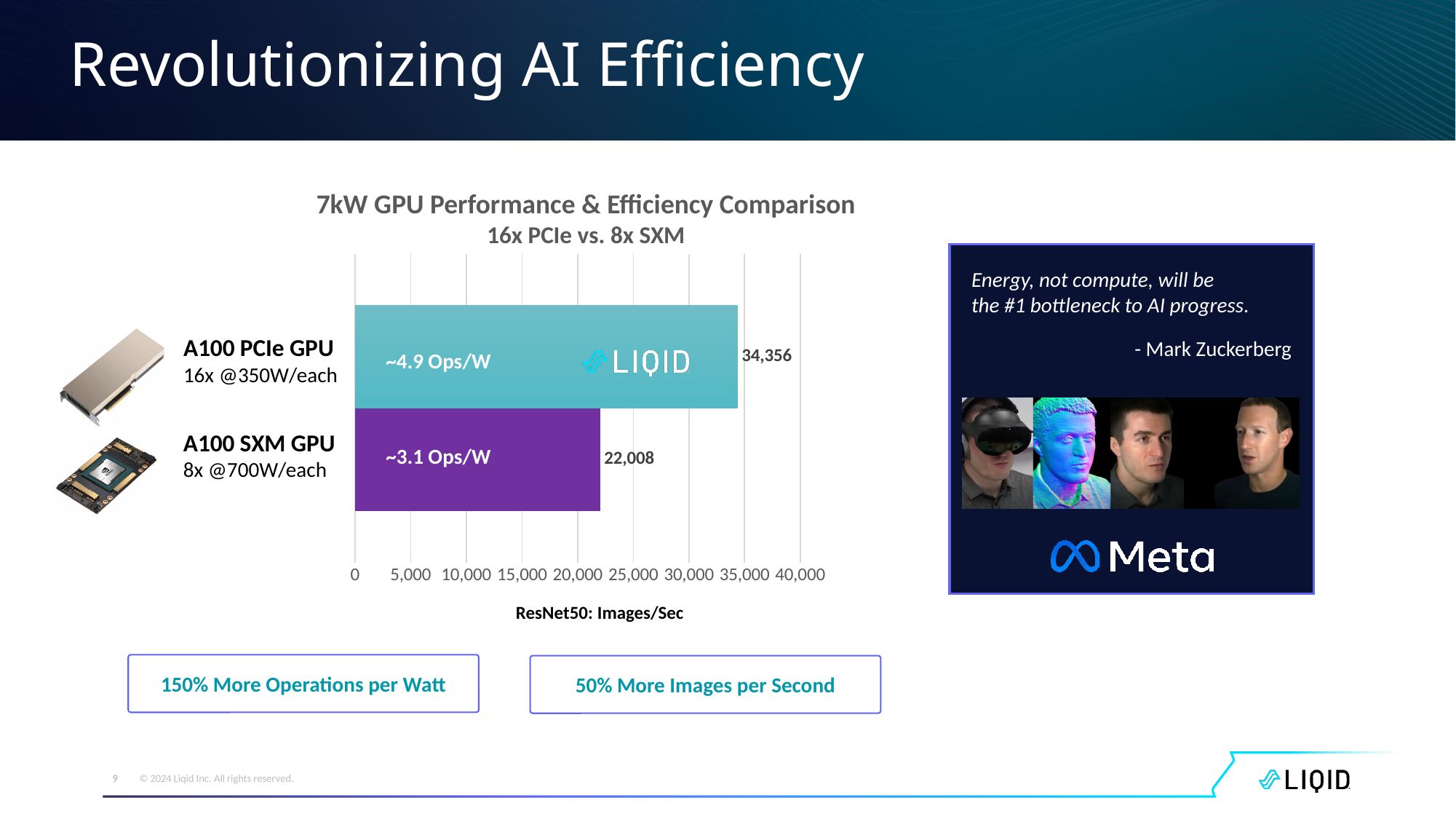
What is the ResNet50 Images/Sec value for the A100 SXM GPU? 22,008 How many GPU configurations are plotted in the chart? 2 What is the difference in ResNet50 Images/Sec between the A100 PCIe GPU and the A100 SXM GPU? 12,348 Is the ResNet50 Images/Sec value for the A100 SXM GPU greater or less than 25,000? less What is the title of the chart? 7kW GPU Performance & Efficiency Comparison 16x PCIe vs. 8x SXM What is the ResNet50 Images/Sec value for the A100 PCIe GPU? 34,356 Which GPU configuration has the lower ResNet50 Images/Sec value? A100 SXM GPU Which GPU configuration has the higher ResNet50 Images/Sec value? A100 PCIe GPU What is the highest tick value shown on the x axis of the chart? 40,000 What is the x-axis label of the chart? ResNet50: Images/Sec What kind of chart is shown on the slide? Bar chart Is the ResNet50 Images/Sec value for the A100 PCIe GPU greater or less than 30,000? greater